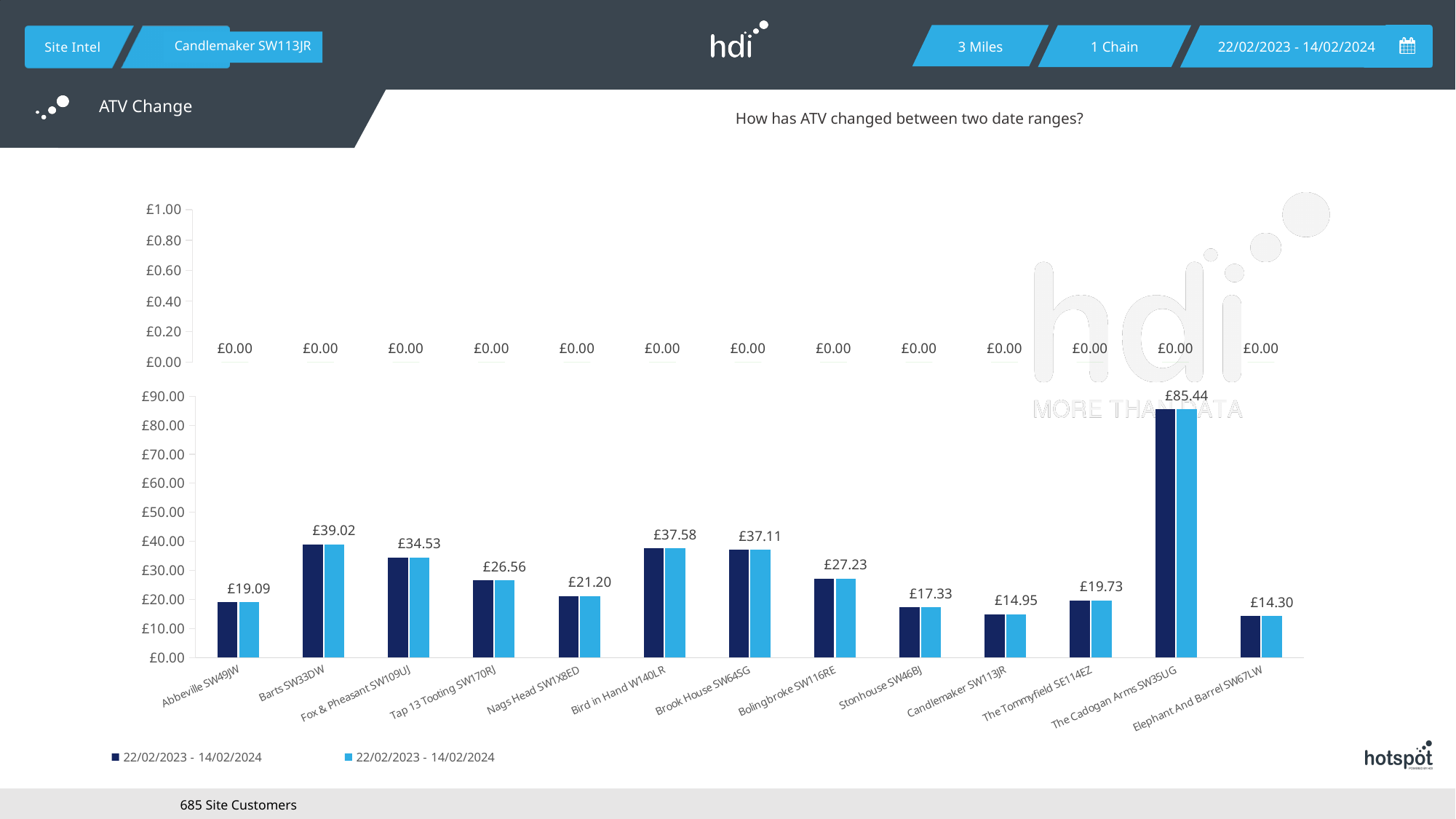
How many series does the legend list? 2 On the top chart, what value is shown for every site? £0.00 On the bottom chart, what is the difference between the values for Barts SW33DW and Abbeville SW49JW? £19.93 On the bottom chart, what is the value shown for The Cadogan Arms SW35UG? £85.44 On the bottom chart, which site has the lowest value? Elephant And Barrel SW67LW On the bottom chart, which is larger: the value for Brook House SW64SG or Bolingbroke SW116RE? Brook House SW64SG What kind of chart is the bottom chart? bar chart On the bottom chart, what is the value shown for Candlemaker SW113JR? £14.95 On the bottom chart, is the value for Fox & Pheasant SW109UJ greater or less than £30.00? greater On the bottom chart, what is the value shown for Bird in Hand W140LR? £37.58 How many sites are shown on the bottom chart? 13 On the bottom chart, which site has the highest value? The Cadogan Arms SW35UG